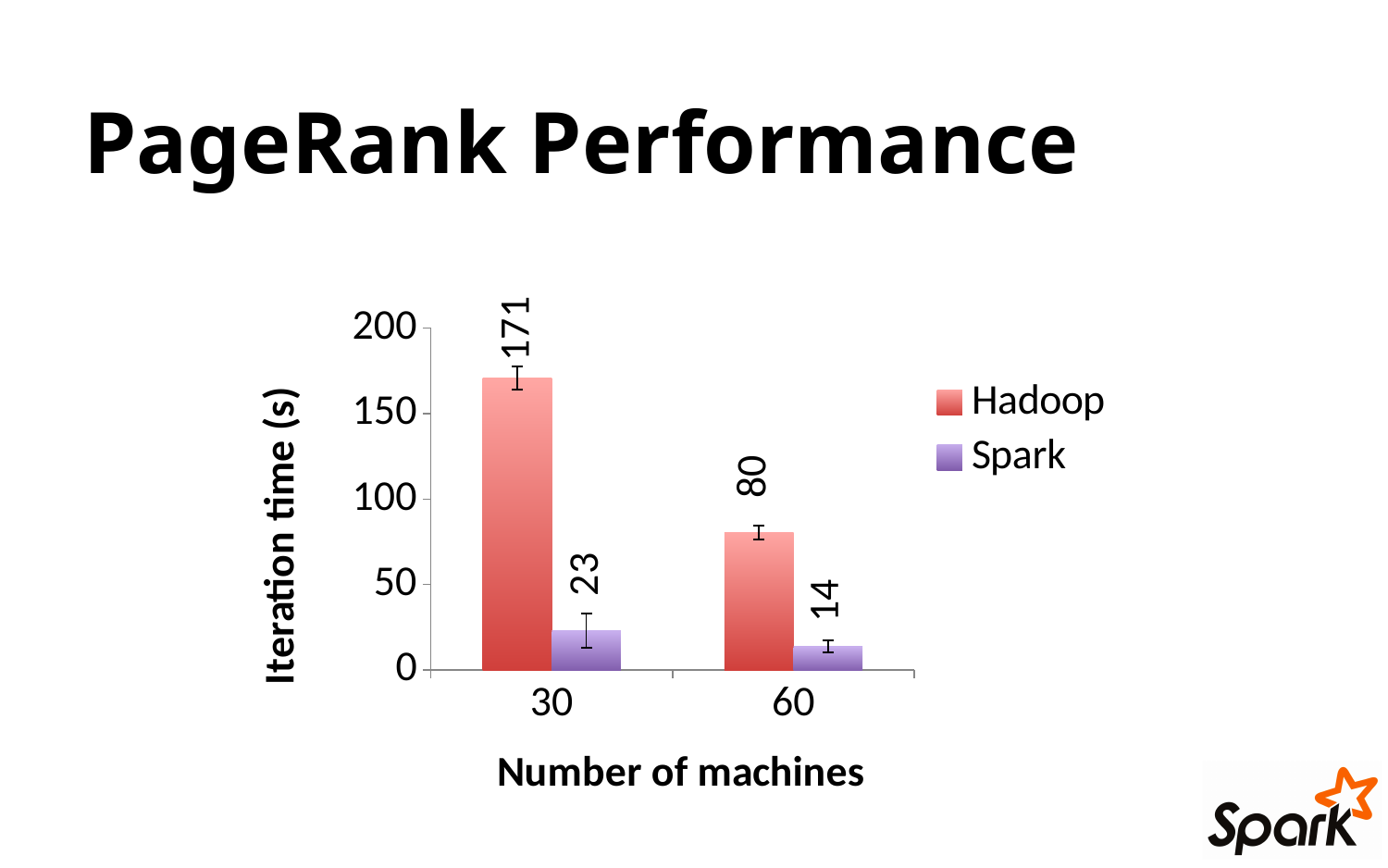
What kind of chart is shown on the slide? Bar chart Which has a larger iteration time at 60 machines, Hadoop or Spark? Hadoop What is the iteration time for Hadoop with 60 machines? 80 What is the iteration time for Hadoop with 30 machines? 171 Which bar has the lowest iteration time? Spark with 60 machines How many categories are shown on the x axis? 2 What is the iteration time for Spark with 30 machines? 23 How many series does the legend list? 2 Which bar has the highest iteration time? Hadoop with 30 machines What is the iteration time for Spark with 60 machines? 14 What is the difference in iteration time between Hadoop and Spark at 30 machines? 148 Does the Hadoop iteration time rise or fall as the number of machines increases from 30 to 60? Fall